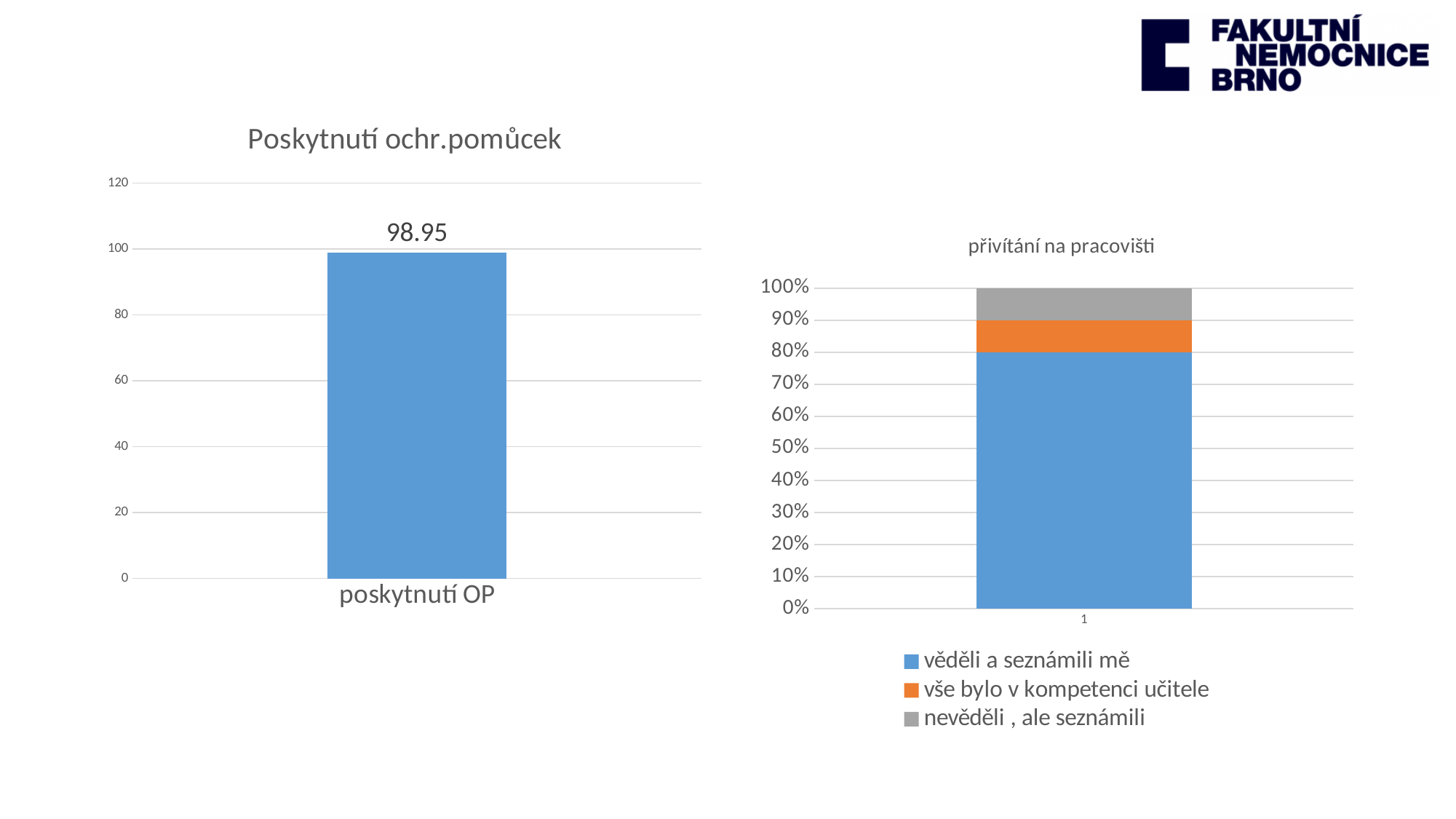
In the chart titled 'přivítání na pracovišti', which series has the largest segment? věděli a seznámili mě In the chart titled 'přivítání na pracovišti', which is larger: the segment for 'věděli a seznámili mě' or the segment for 'nevěděli , ale seznámili'? věděli a seznámili mě In the chart titled 'Poskytnutí ochr.pomůcek', is the value for 'poskytnutí OP' greater or less than 80? greater In the chart titled 'Poskytnutí ochr.pomůcek', what is the value for 'poskytnutí OP'? 98.95 How many series does the legend list in the chart titled 'přivítání na pracovišti'? 3 What kind of chart is the chart titled 'přivítání na pracovišti'? stacked bar chart What kind of chart is the chart titled 'Poskytnutí ochr.pomůcek'? bar chart In the chart titled 'přivítání na pracovišti', is the share for 'vše bylo v kompetenci učitele' greater or less than 20%? less In the chart titled 'přivítání na pracovišti', is the share for 'věděli a seznámili mě' greater or less than 70%? greater How many bars are plotted in the chart titled 'Poskytnutí ochr.pomůcek'? 1 In the chart titled 'přivítání na pracovišti', which colour represents 'nevěděli , ale seznámili'? gray